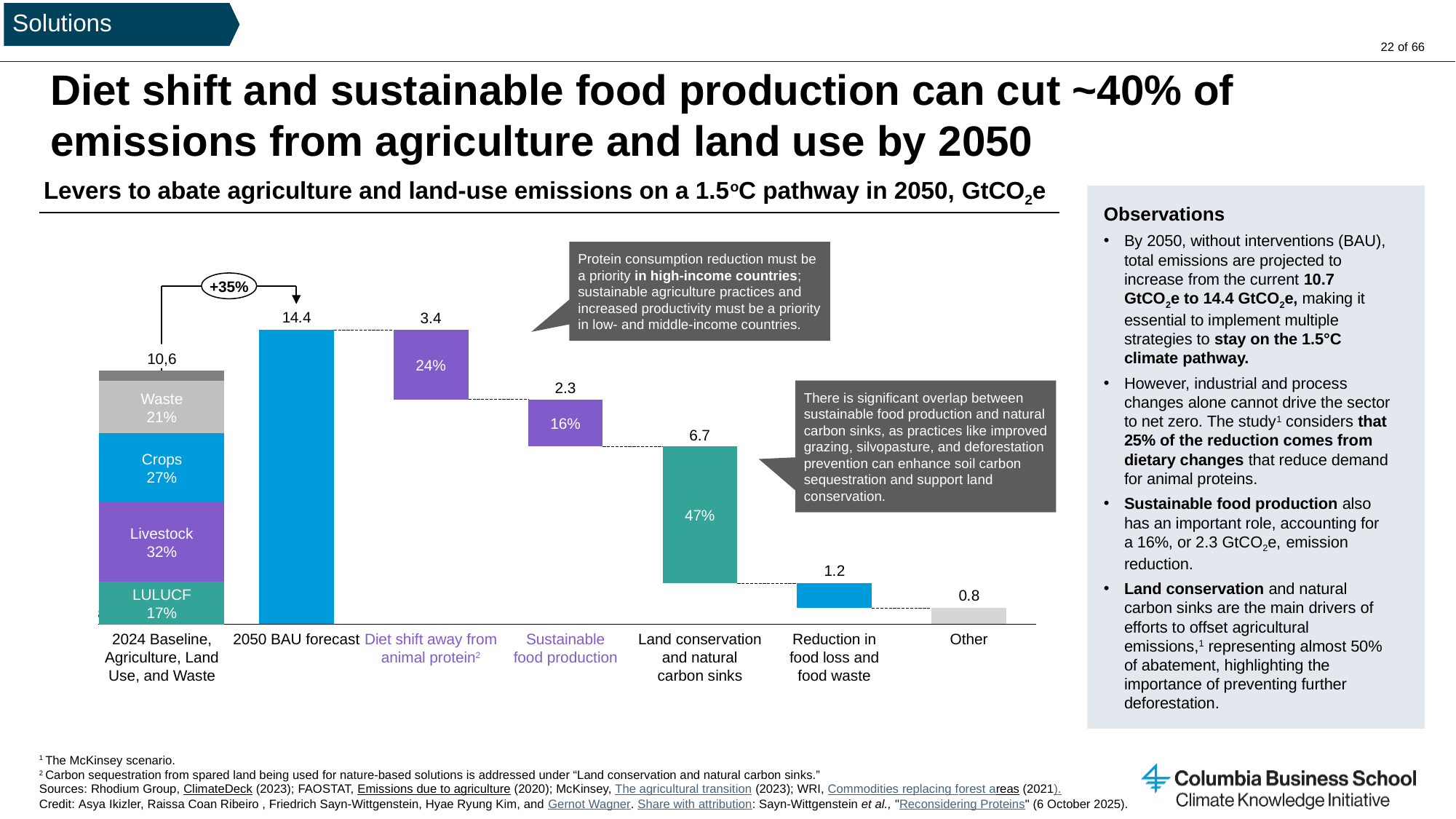
What percentage is printed inside the Sustainable food production bar? 16% What value is shown for the Diet shift away from animal protein lever? 3.4 What is the value shown for the 2050 BAU forecast bar? 14.4 What share of the 2024 Baseline bar is Livestock? 32% What is the difference between the 2050 BAU forecast and the 2024 Baseline values? 3.8 What percentage increase is annotated between the 2024 Baseline and the 2050 BAU forecast? +35% Which abatement lever has the smallest value? Other What is the value shown for the Land conservation and natural carbon sinks lever? 6.7 What kind of chart is shown on the slide? Bar chart (waterfall) How many categories are shown along the x axis of the chart? 7 Which is larger, the value for Diet shift away from animal protein or the value for Sustainable food production? Diet shift away from animal protein Which abatement lever has the largest value? Land conservation and natural carbon sinks